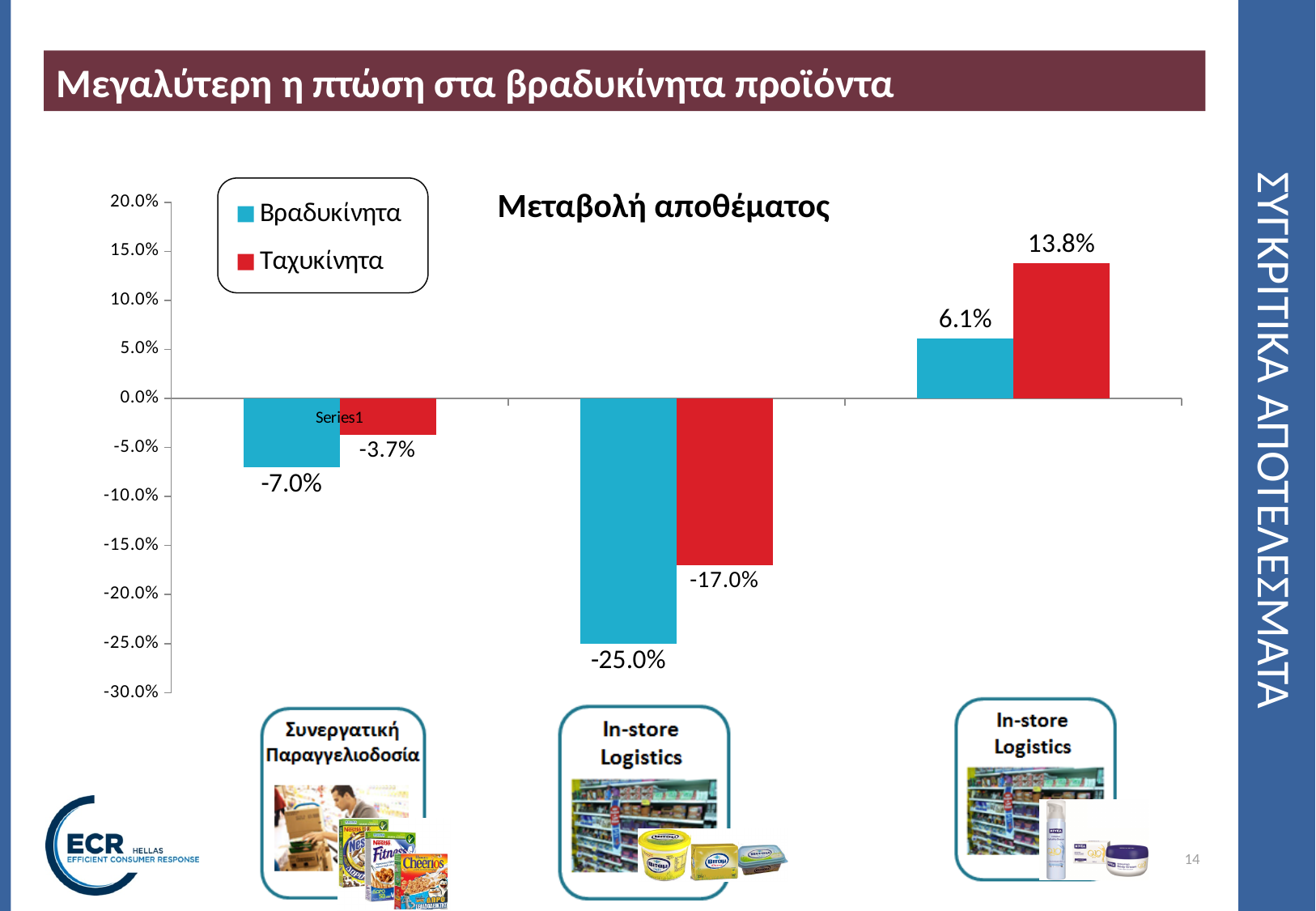
How many series does the chart legend list? 2 What is the title of the chart? Μεταβολή αποθέματος What kind of chart is shown on the slide? bar chart What is the highest value shown in the chart? 13.8% How many category groups of bars are plotted in the chart? 3 What is the value for Ταχυκίνητα in the Συνεργατική Παραγγελιοδοσία category? -3.7% Which colour represents the Ταχυκίνητα series? red What is the difference between the Ταχυκίνητα and Βραδυκίνητα values in the rightmost category group? 7.7% Which series has the lowest value in the chart, and what is it? Βραδυκίνητα, -25.0% What is the value for Ταχυκίνητα in the rightmost category group? 13.8% What is the value for Βραδυκίνητα in the Συνεργατική Παραγγελιοδοσία category? -7.0% What is the value for Βραδυκίνητα in the middle category group? -25.0%